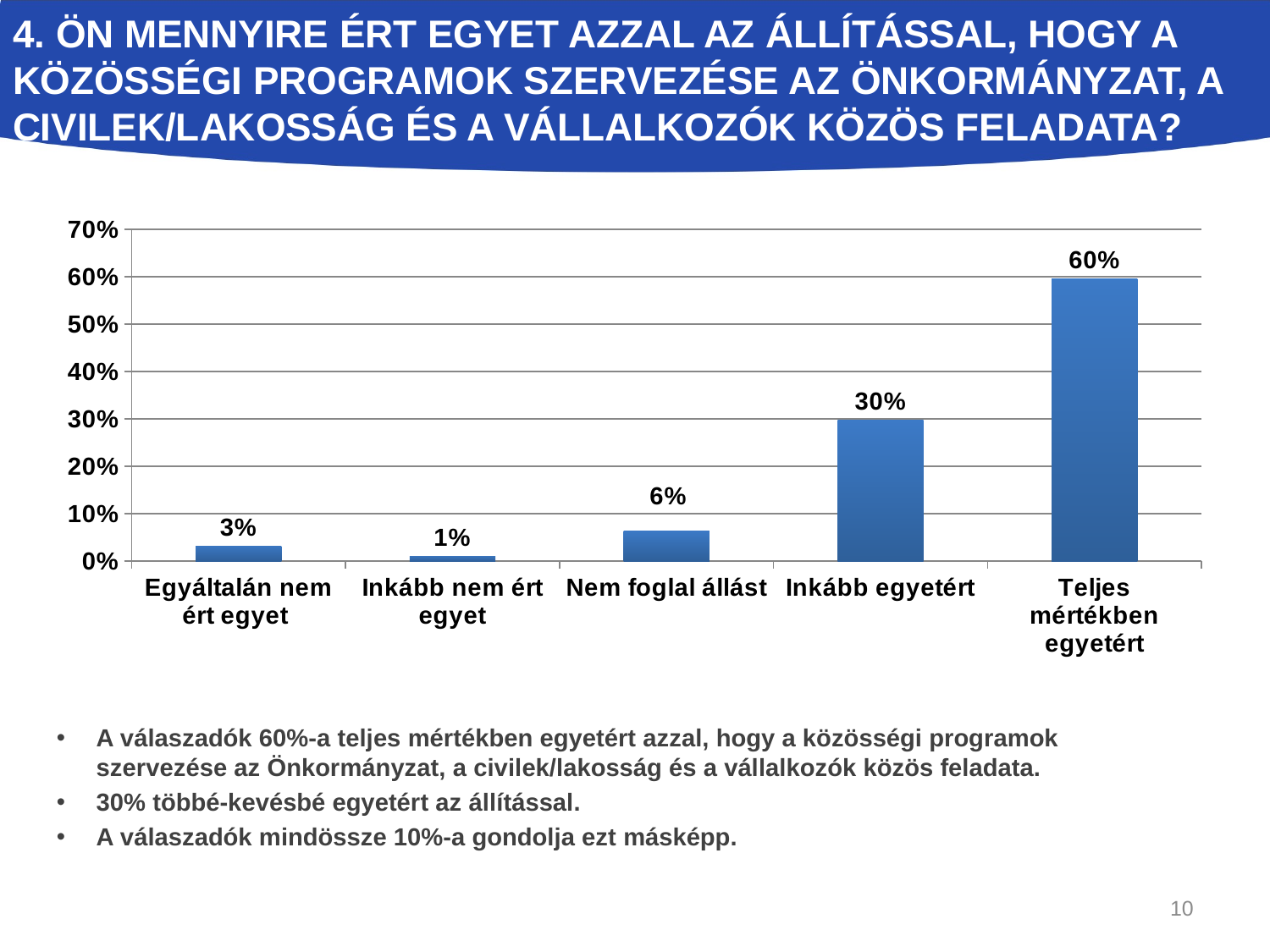
What is the value for "Inkább egyetért"? 30% What is the value for "Teljes mértékben egyetért"? 60% What kind of chart is shown on the slide? Bar chart How many categories are shown on the x axis? 5 What is the difference between the values for "Teljes mértékben egyetért" and "Inkább egyetért"? 30% Which category has the highest value? Teljes mértékben egyetért Which is larger, the value for "Nem foglal állást" or the value for "Inkább nem ért egyet"? Nem foglal állást What is the value for "Egyáltalán nem ért egyet"? 3% What is the value for "Nem foglal állást"? 6% Do the values generally rise or fall from left to right along the x axis? Rise What is the difference between the values for "Nem foglal állást" and "Egyáltalán nem ért egyet"? 3% Which category has the lowest value? Inkább nem ért egyet